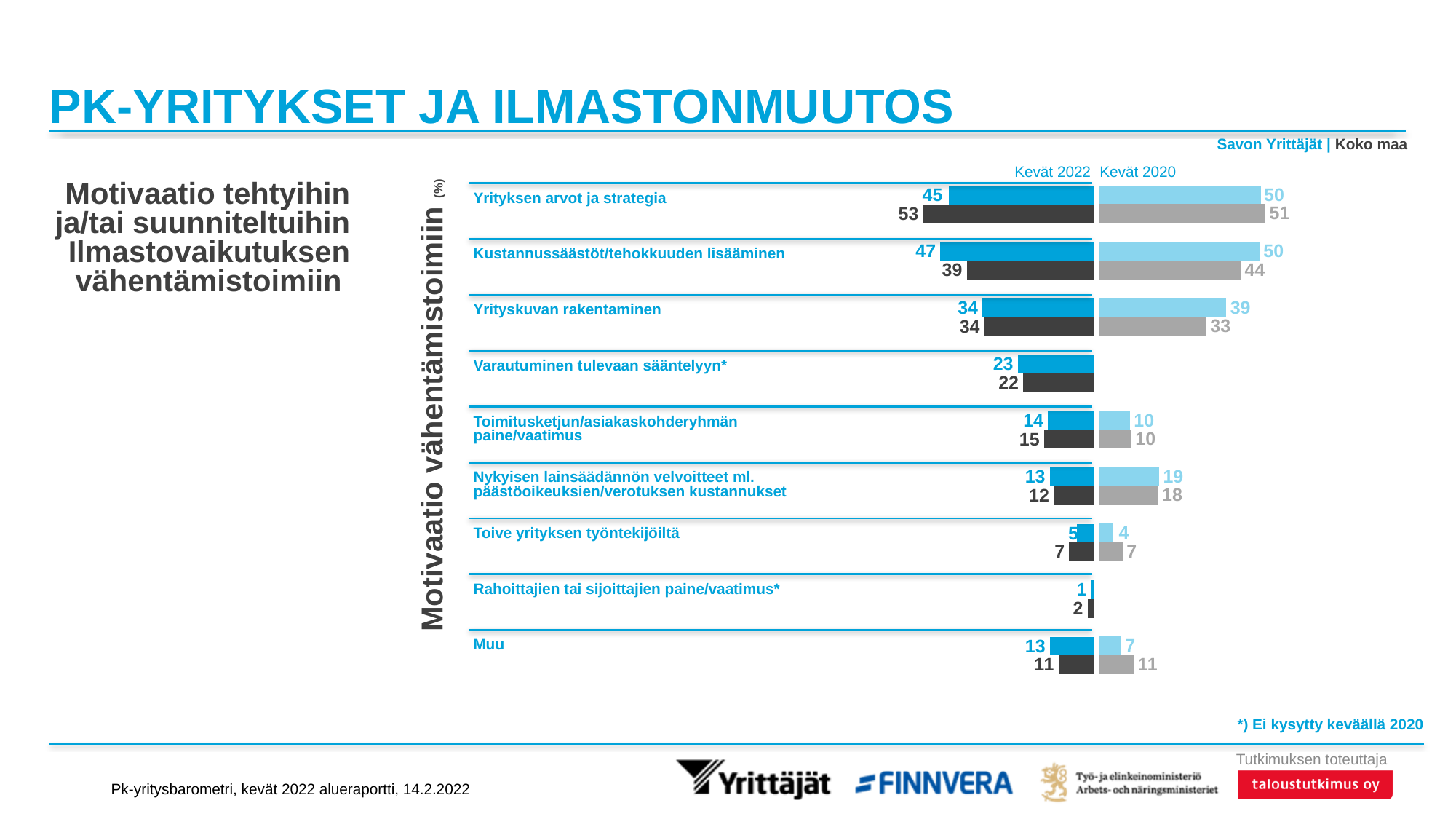
What is the Savon Yrittäjät value for Kevät 2022 for 'Yrityksen arvot ja strategia'? 45 What is the Koko maa value for Kevät 2022 for 'Nykyisen lainsäädännön velvoitteet ml. päästöoikeuksien/verotuksen kustannukset'? 12 How many categories are listed in the chart? 9 Which two survey rounds are compared in the chart? Kevät 2022 and Kevät 2020 Which category has the highest Savon Yrittäjät value for Kevät 2022? Kustannussäästöt/tehokkuuden lisääminen What is the Koko maa value for Kevät 2020 for 'Kustannussäästöt/tehokkuuden lisääminen'? 44 What is the difference between the Savon Yrittäjät Kevät 2020 and Kevät 2022 values for 'Yrityksen arvot ja strategia'? 5 Which categories are marked with an asterisk as not asked in spring 2020? Varautuminen tulevaan sääntelyyn and Rahoittajien tai sijoittajien paine/vaatimus What kind of chart is shown on the slide? Bar chart Which category has the lowest Savon Yrittäjät value for Kevät 2022? Rahoittajien tai sijoittajien paine/vaatimus* For 'Muu', which is larger: the Savon Yrittäjät Kevät 2022 value or the Koko maa Kevät 2022 value? Savon Yrittäjät Kevät 2022